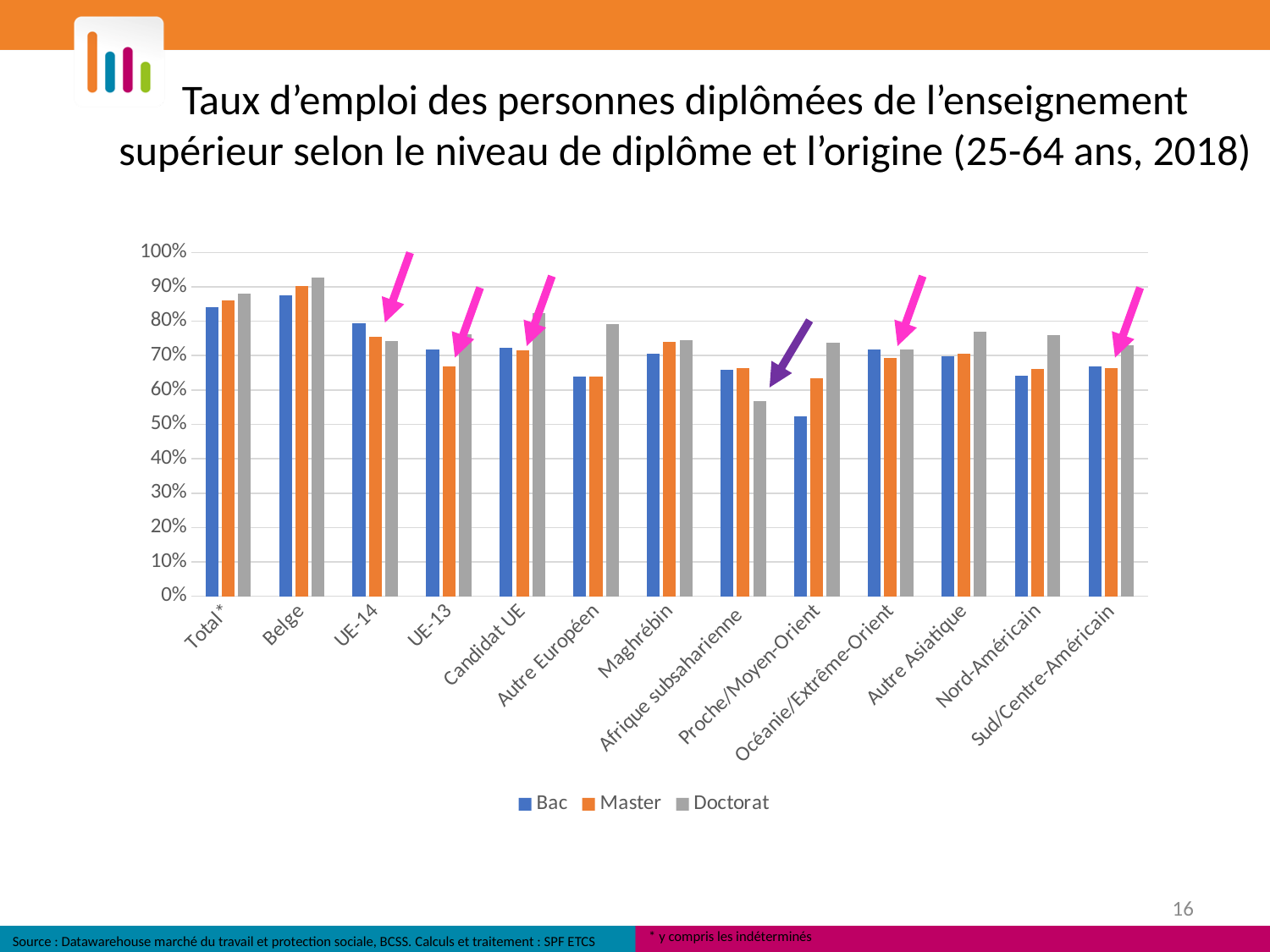
For Proche/Moyen-Orient, which is larger: the Bac value or the Doctorat value? Doctorat How many series does the legend list? 3 What kind of chart is shown on the slide? bar chart Is the Bac value for Total* greater or less than 80%? greater For Afrique subsaharienne, which is larger: the Bac value or the Doctorat value? Bac Is the Bac value for Proche/Moyen-Orient greater or less than 60%? less Which category has the highest Doctorat value? Belge What colour represents the Master series in the legend? orange Which category has the lowest Doctorat value? Afrique subsaharienne Which category has the highest Bac value? Belge Which category has the lowest Bac value? Proche/Moyen-Orient How many origin categories are shown on the x axis? 13